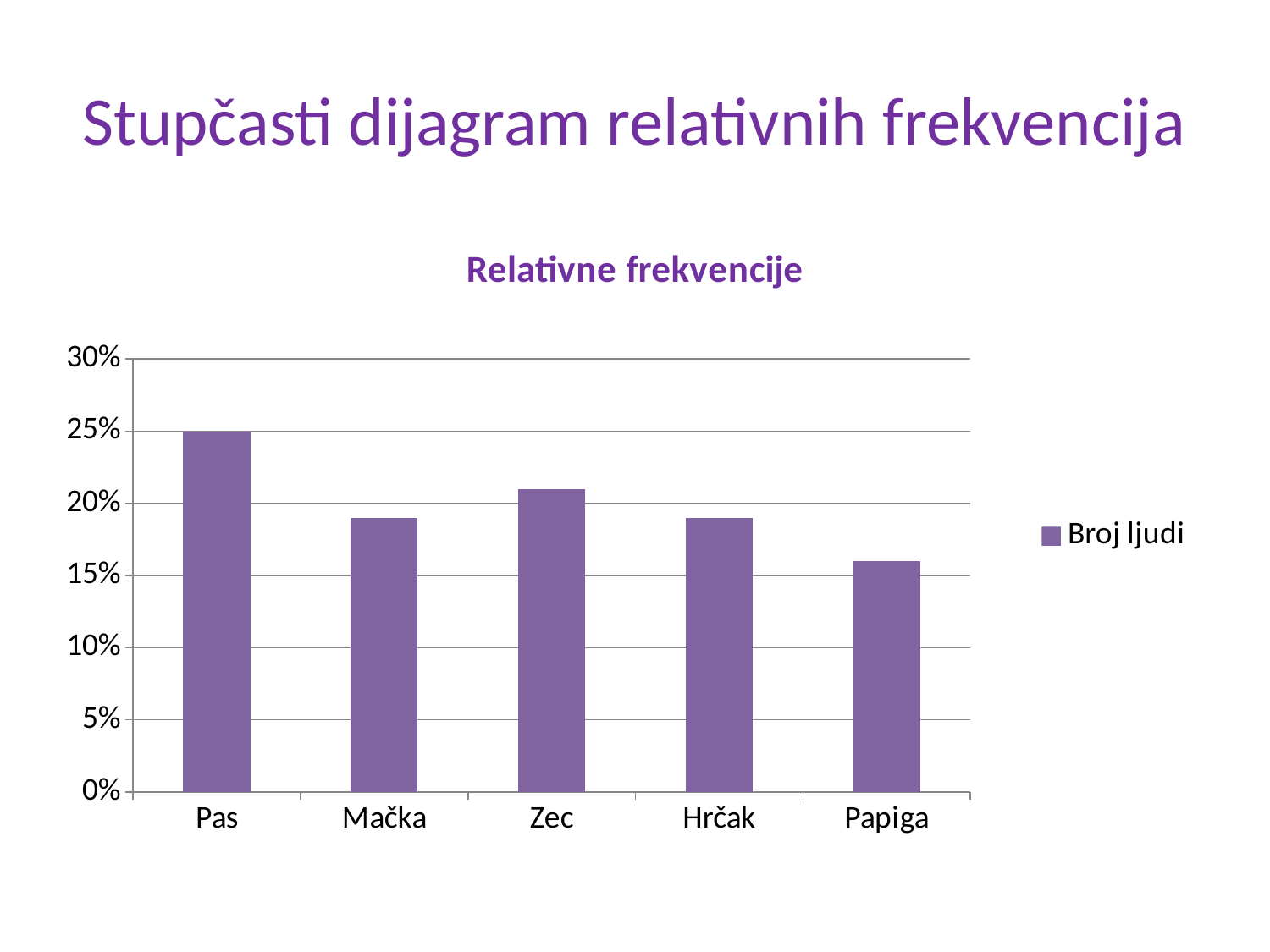
Which category has the highest value? Pas Which has the larger value, Zec or Mačka? Zec How many series does the legend list? 1 Which category has the lowest value? Papiga What series name does the legend show? Broj ljudi How many categories are shown on the x axis? 5 What is the value for Pas? 25% Is the value for Papiga greater or less than 20%? less What is the title of the chart? Relativne frekvencije What type of chart is shown on the slide? bar chart Is the value for Zec greater or less than 20%? greater Is the value for Hrčak greater or less than 20%? less